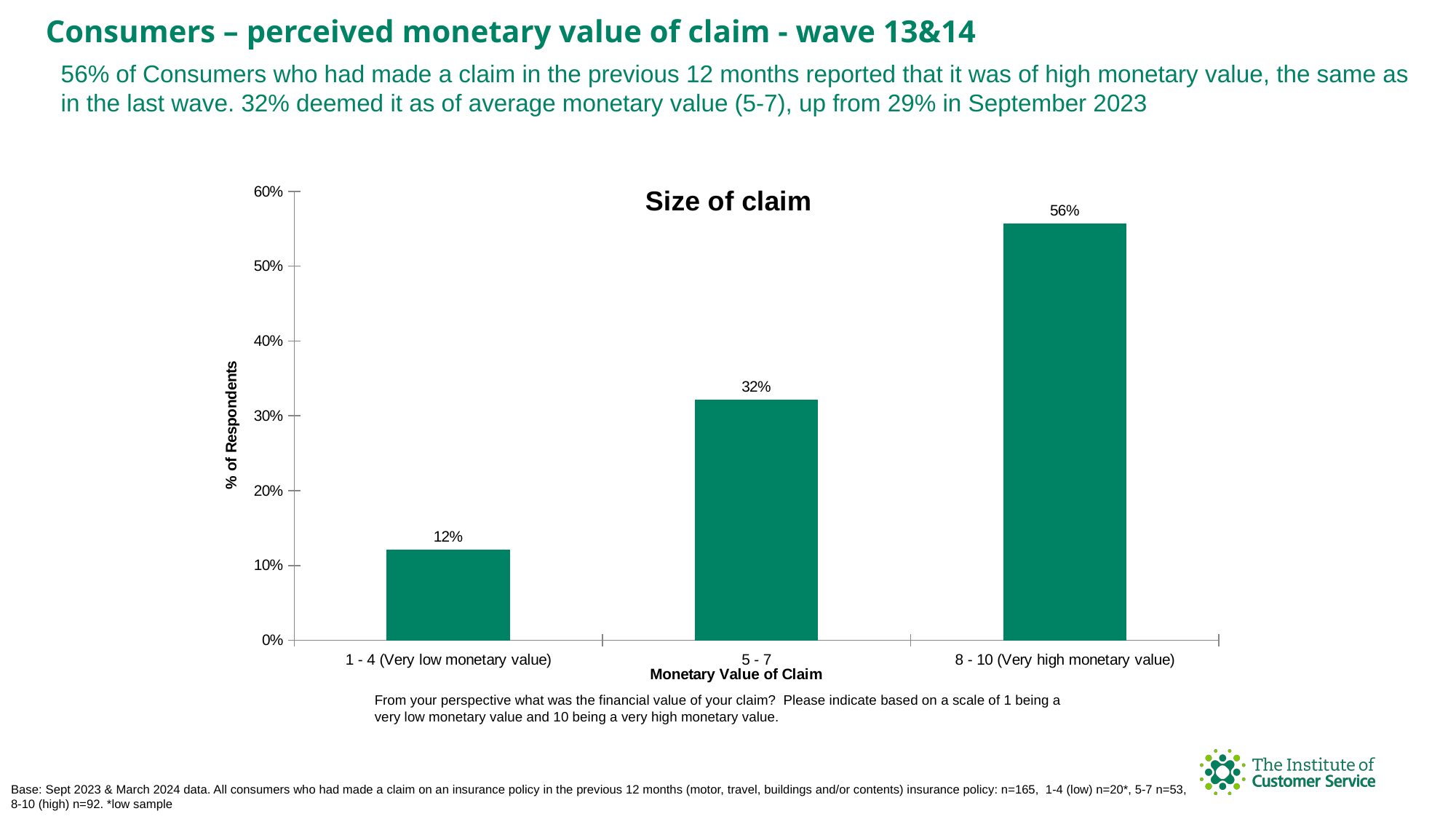
Which category has a larger share of respondents: 5 - 7 or 1 - 4 (Very low monetary value)? 5 - 7 What percentage of respondents rated their claim as 8 - 10 (Very high monetary value)? 56% Is the value for 8 - 10 (Very high monetary value) greater or less than 50%? greater What type of chart is used to show the size of claim data? Bar chart Which monetary value category has the lowest percentage of respondents? 1 - 4 (Very low monetary value) What percentage of respondents rated their claim as 5 - 7? 32% What percentage of respondents rated their claim as 1 - 4 (Very low monetary value)? 12% What is the title of the chart? Size of claim What is the difference in percentage points between the 8 - 10 (Very high monetary value) and 5 - 7 categories? 24 percentage points How many monetary value categories are shown on the chart? 3 Which monetary value category has the highest percentage of respondents? 8 - 10 (Very high monetary value) What is the difference in percentage points between the 5 - 7 and 1 - 4 (Very low monetary value) categories? 20 percentage points